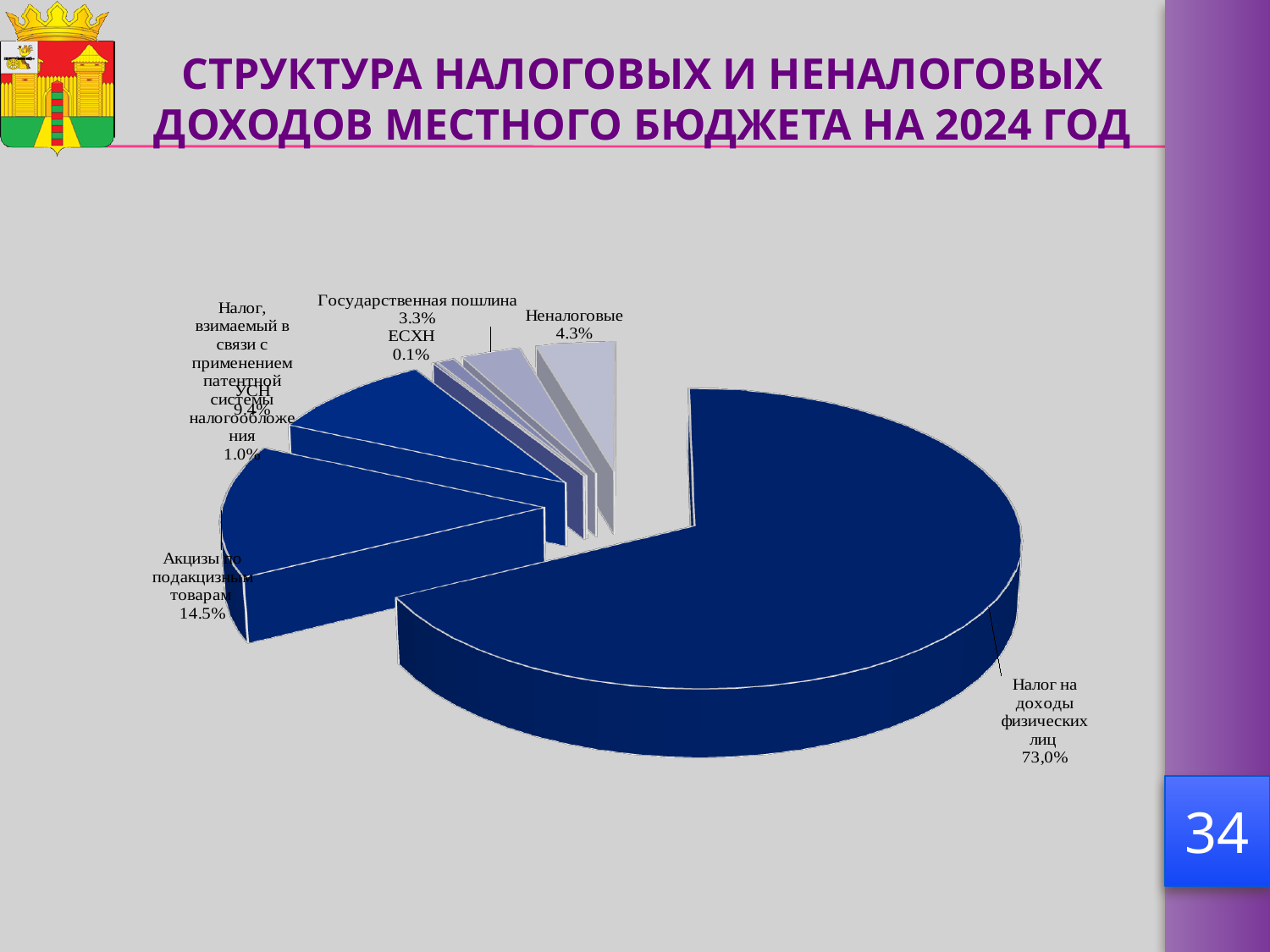
How many slices does the pie chart have? 7 What type of chart is shown on the slide? pie chart What is the value shown for "Акцизы по подакцизным товарам"? 14.5% What share of the pie does "Налог на доходы физических лиц" have? 73,0% Which category has the largest share of the pie? Налог на доходы физических лиц Which is larger: the share for "Неналоговые" or the share for "Государственная пошлина"? Неналоговые What is the value shown for "ЕСХН"? 0.1% What is the value shown for "УСН"? 9.4% What is the value shown for "Государственная пошлина"? 3.3% Which category has the smallest share of the pie? ЕСХН What is the value shown for "Неналоговые"? 4.3% What is the difference between the shares for "Акцизы по подакцизным товарам" and "УСН"? 5.1%